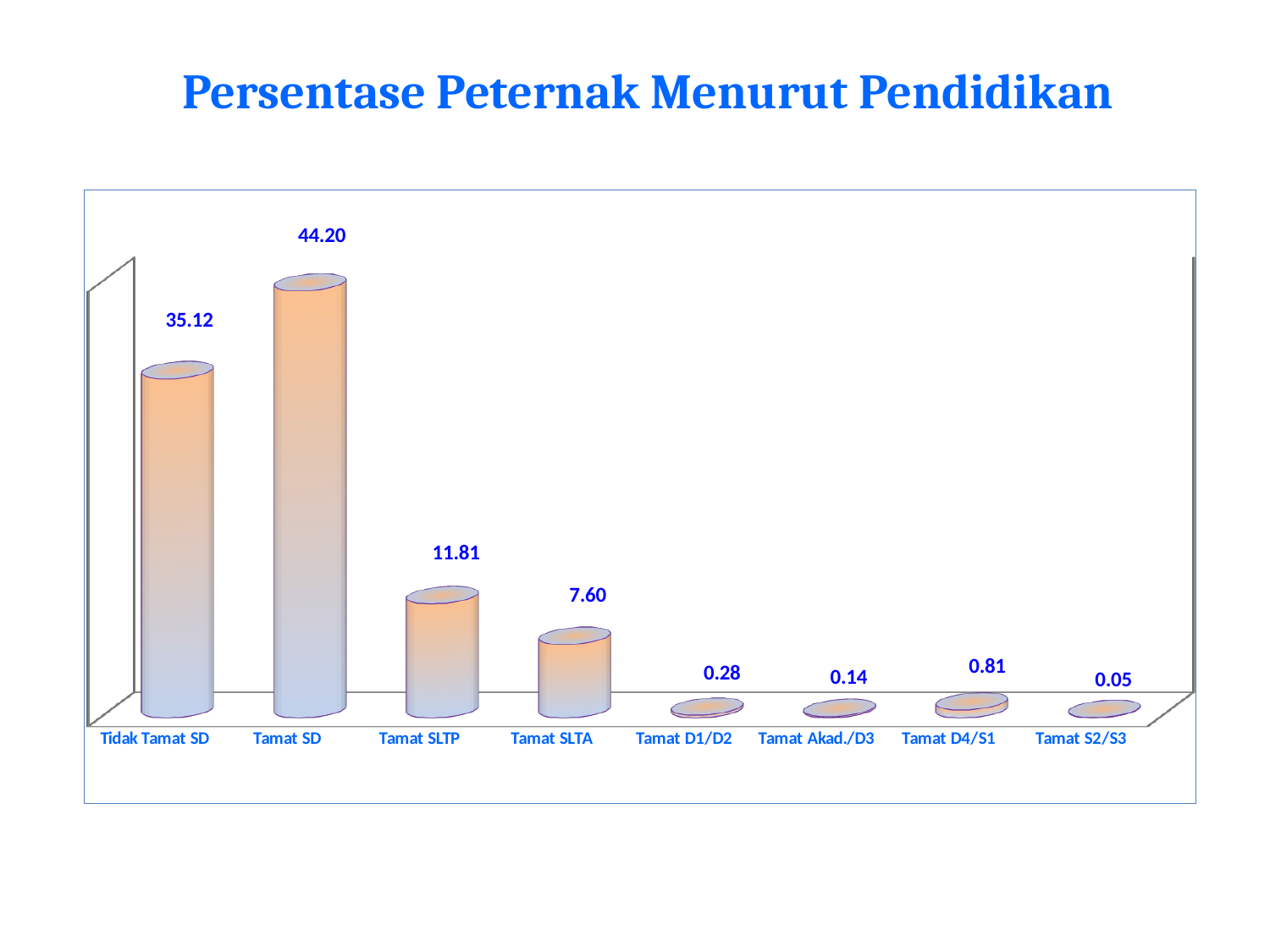
Which is larger, the value for Tamat D1/D2 or the value for Tamat Akad./D3? Tamat D1/D2 What is the difference between the values for Tamat SD and Tidak Tamat SD? 9.08 What is the value for Tidak Tamat SD? 35.12 What is the title of the chart? Persentase Peternak Menurut Pendidikan What is the value for Tamat SD? 44.20 How many categories are shown on the x axis? 8 What kind of chart is shown on the slide? Bar chart What is the value for Tamat D4/S1? 0.81 What is the value for Tamat SLTA? 7.60 Which category has the lowest value? Tamat S2/S3 What is the difference between the values for Tamat SLTP and Tamat SLTA? 4.21 Which category has the highest value? Tamat SD